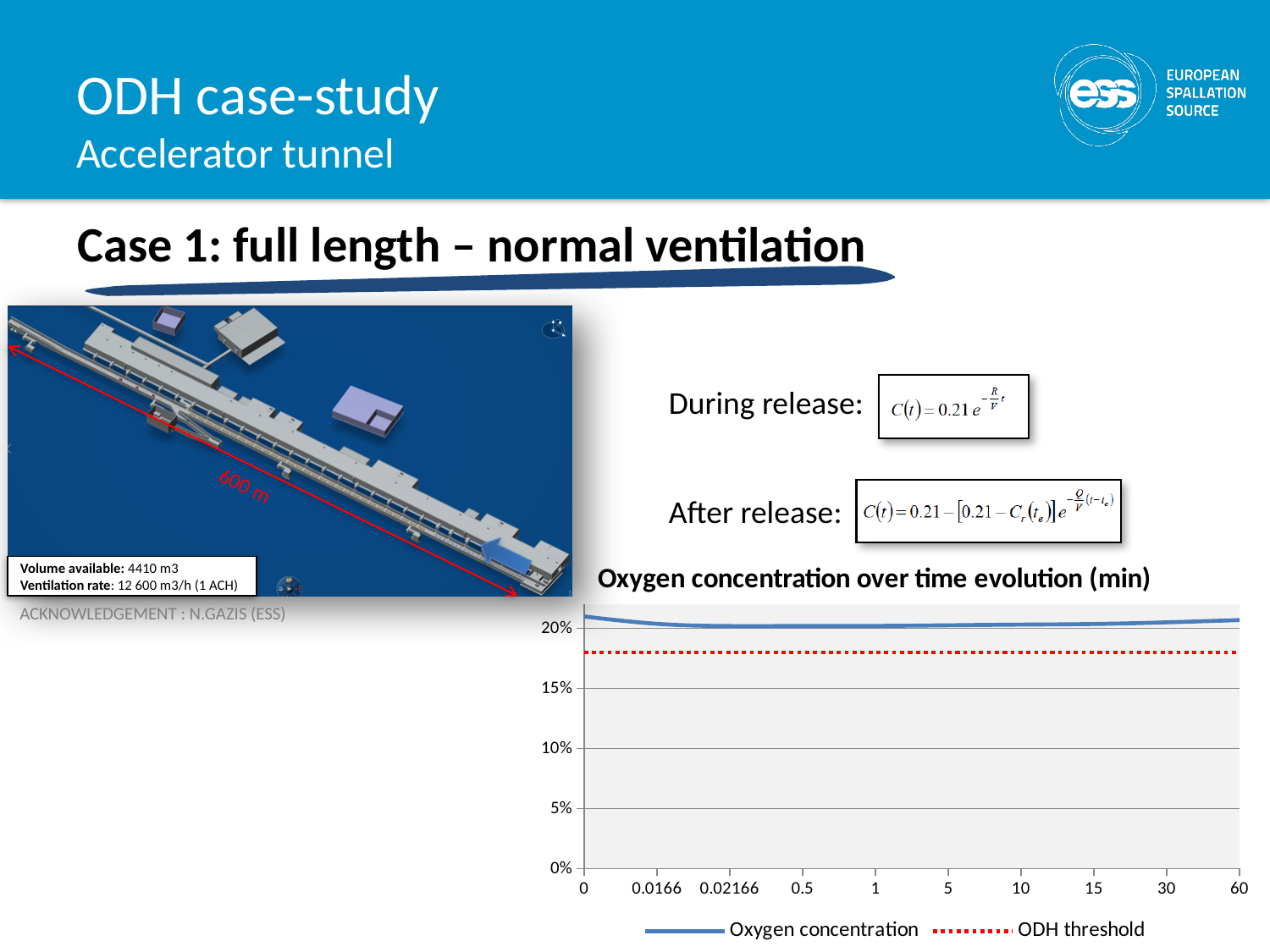
What is the highest tick label shown on the y axis of the chart? 20% Which series is drawn as a dotted red line? ODH threshold Is the Oxygen concentration value at time 0 greater or less than 20%? greater Does the Oxygen concentration line ever drop below the ODH threshold line? No Is the ODH threshold line greater or less than 20%? less How many series does the chart legend list? 2 What kind of chart is shown on the slide? Line chart Is the ODH threshold line greater or less than 15%? greater What are the two series named in the chart legend? Oxygen concentration and ODH threshold How many tick labels are shown on the x axis of the chart? 10 Which series is higher throughout the chart, Oxygen concentration or ODH threshold? Oxygen concentration